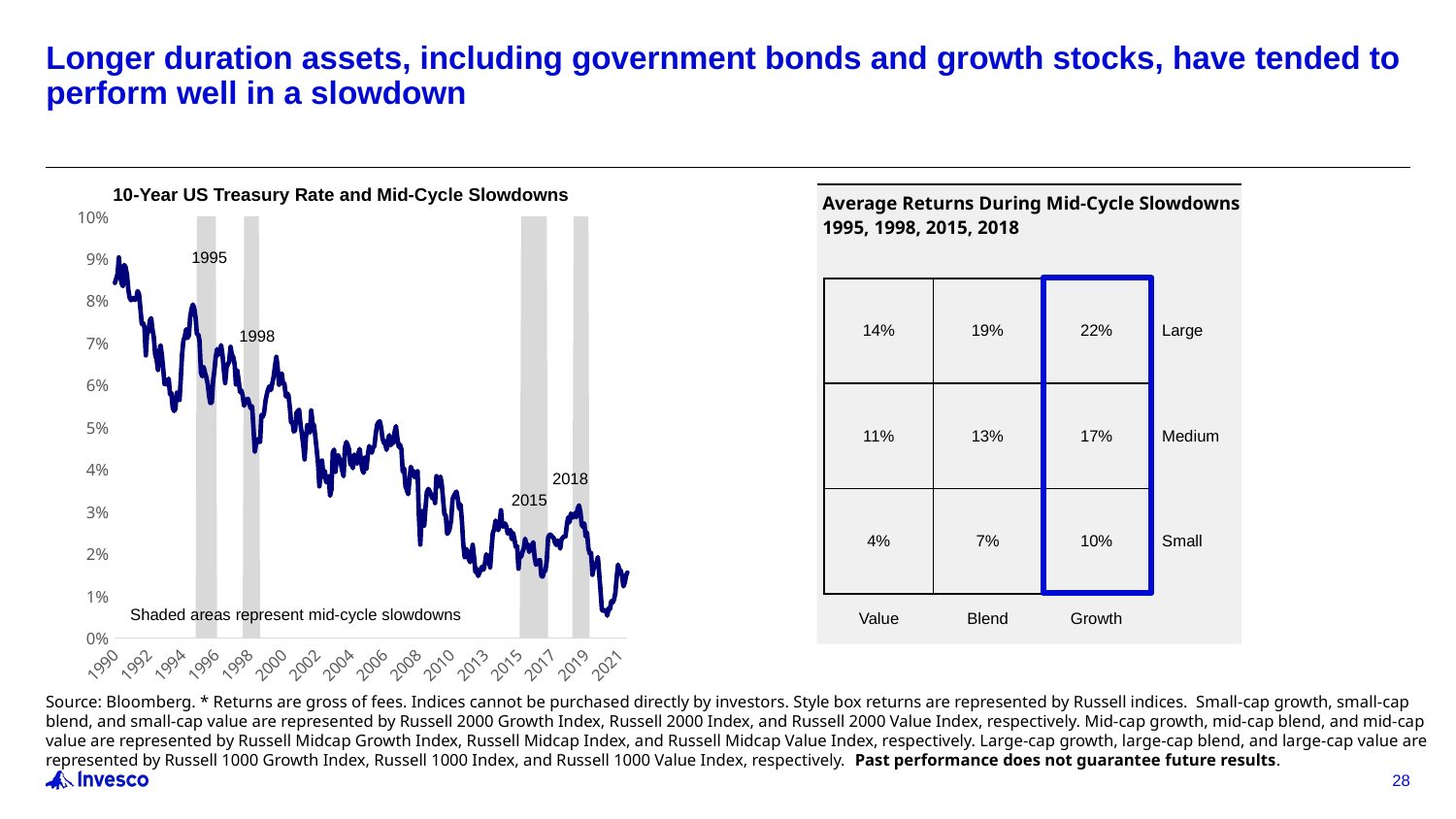
In the '10-Year US Treasury Rate and Mid-Cycle Slowdowns' chart, what do the shaded areas represent? Mid-cycle slowdowns In the '10-Year US Treasury Rate and Mid-Cycle Slowdowns' chart, is the Treasury rate at the start of 1990 greater or less than 8%? greater In the 'Average Returns During Mid-Cycle Slowdowns' style box, what is the average return for Large Growth? 22% What type of chart is the '10-Year US Treasury Rate and Mid-Cycle Slowdowns' chart? Line chart In the '10-Year US Treasury Rate and Mid-Cycle Slowdowns' chart, is the Treasury rate around 2008 greater or less than 5%? less In the 'Average Returns During Mid-Cycle Slowdowns' style box, what is the difference between the Large Growth and Small Growth returns? 12% In the 'Average Returns During Mid-Cycle Slowdowns' style box, what is the average return for Small Value? 4% In the '10-Year US Treasury Rate and Mid-Cycle Slowdowns' chart, does the 10-year Treasury rate generally rise or fall from 1990 to 2021? Fall In the '10-Year US Treasury Rate and Mid-Cycle Slowdowns' chart, how many shaded mid-cycle slowdown areas are shown? 4 In the '10-Year US Treasury Rate and Mid-Cycle Slowdowns' chart, which years are labeled as mid-cycle slowdowns? 1995, 1998, 2015, 2018 In the 'Average Returns During Mid-Cycle Slowdowns' style box, which is larger, the Medium Blend return or the Medium Value return? Medium Blend (13%) In the 'Average Returns During Mid-Cycle Slowdowns' style box, which cell has the highest average return? Large Growth (22%)